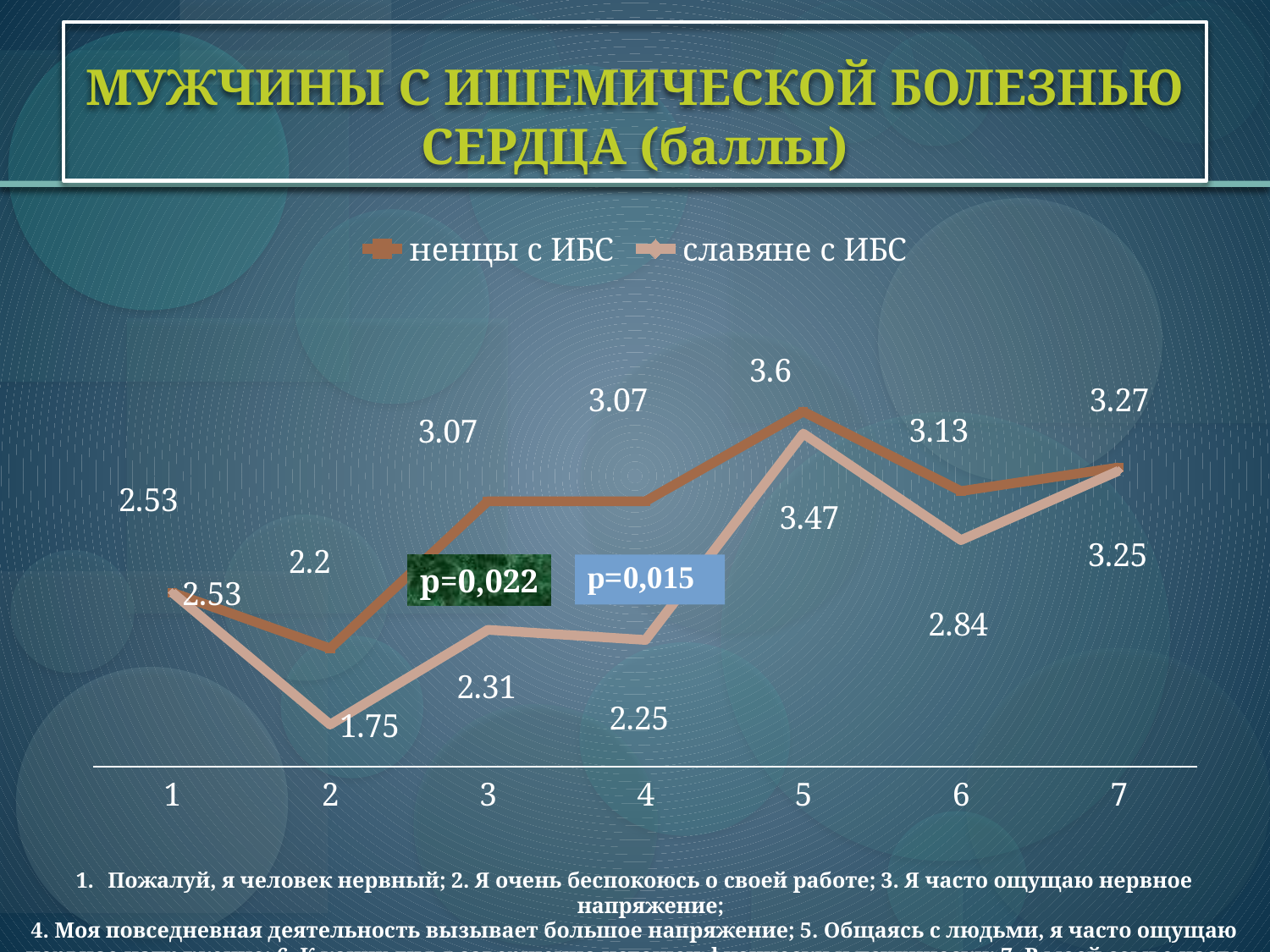
At which category does the "славяне с ИБС" series have its lowest value? 2 Which series has the larger value at category 6, "ненцы с ИБС" or "славяне с ИБС"? ненцы с ИБС How many series does the legend list? 2 What is the value for "ненцы с ИБС" at category 7? 3.27 At which category does the "ненцы с ИБС" series reach its highest value? 5 What is the difference between "ненцы с ИБС" and "славяне с ИБС" at category 4? 0.82 What is the value for "славяне с ИБС" at category 2? 1.75 What is the value for "ненцы с ИБС" at category 5? 3.6 What is the value for "славяне с ИБС" at category 6? 2.84 How many categories are shown on the x axis? 7 What type of chart is shown on the slide? line chart What are the two series named in the legend? ненцы с ИБС and славяне с ИБС